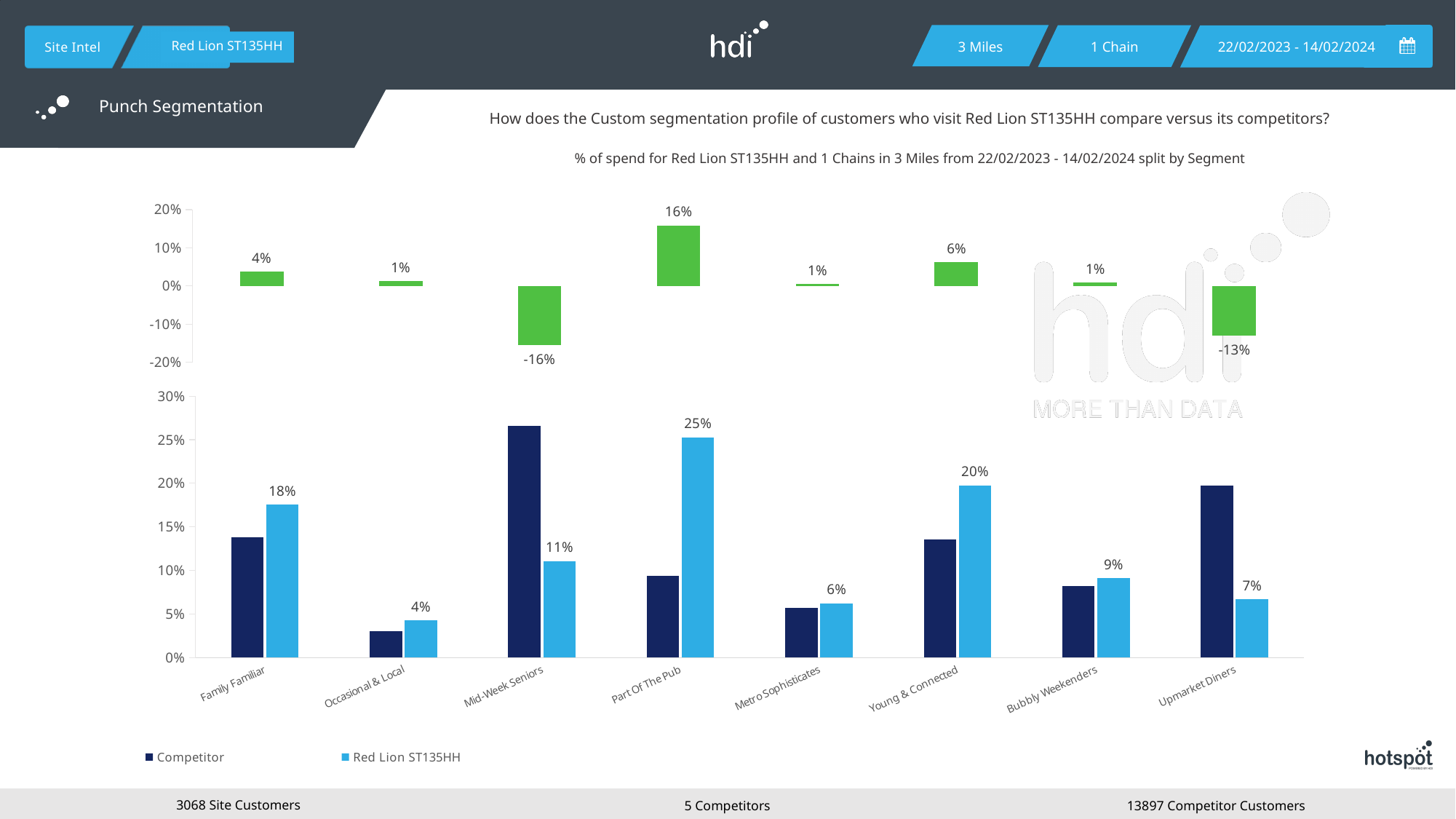
How many series does the legend of the bottom chart list? 2 On the bottom chart, what is the difference between the Red Lion ST135HH values for Young & Connected and Family Familiar? 2 percentage points On the top chart, what is the value shown for Mid-Week Seniors? -16% On the bottom chart, what is the Red Lion ST135HH value for Part Of The Pub? 25% What kind of chart is the bottom chart? bar chart On the bottom chart, which segment has the lowest Red Lion ST135HH value? Occasional & Local On the top chart, which segment has the highest value? Part Of The Pub On the bottom chart, is the Competitor value for Upmarket Diners greater or less than 15%? greater On the bottom chart, for Mid-Week Seniors, which series has the larger value: Competitor or Red Lion ST135HH? Competitor On the bottom chart, which segment has the highest Red Lion ST135HH value? Part Of The Pub How many segments are shown on the bottom chart's x axis? 8 On the top chart, which segment has the lowest value? Mid-Week Seniors